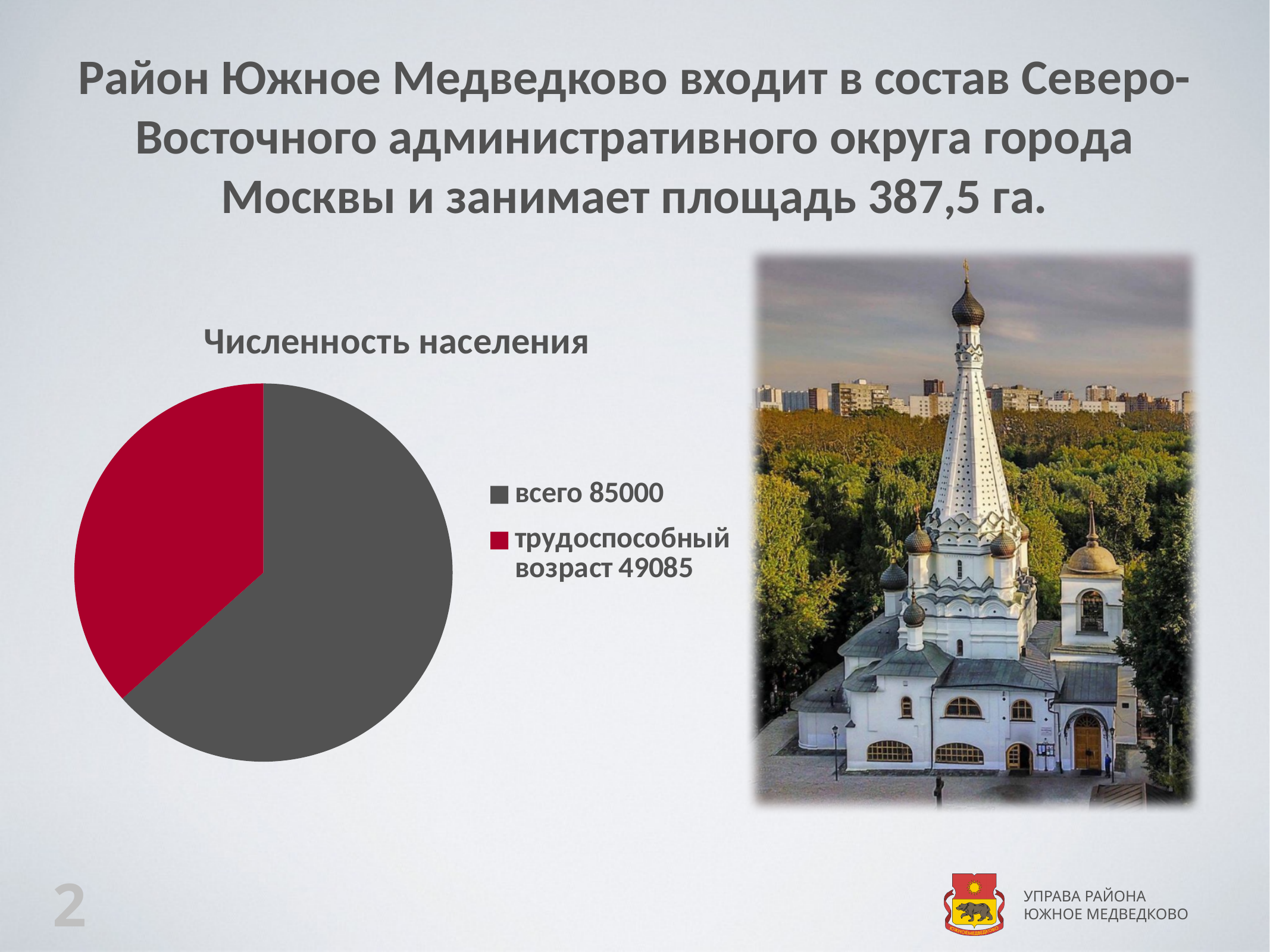
What value is given for "трудоспособный возраст" in the chart legend? 49085 What colour is the slice for "трудоспособный возраст" in the pie chart? red What value is given for "всего" in the chart legend? 85000 What kind of chart is shown on the slide? pie chart Which slice of the pie chart is the smallest? трудоспособный возраст 49085 What is the difference between the value for "всего" and the value for "трудоспособный возраст"? 35915 How many entries does the chart legend list? 2 What is the title of the chart? Численность населения How many slices does the pie chart have? 2 Which slice of the pie chart is the largest? всего 85000 Which is larger, the value for "всего" or the value for "трудоспособный возраст"? всего